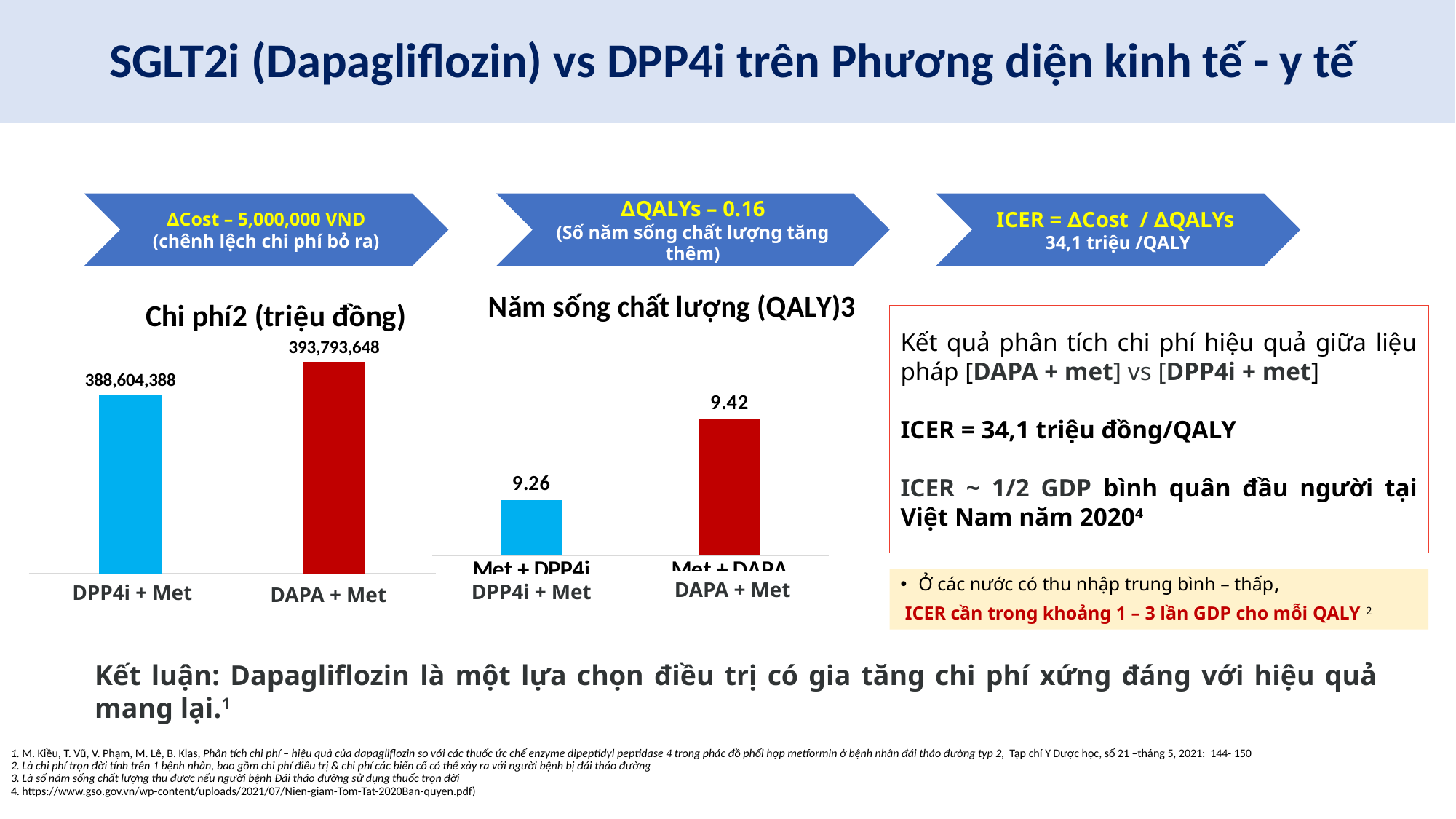
In the 'Chi phí2 (triệu đồng)' chart, which category has the higher value? DAPA + Met In the 'Năm sống chất lượng (QALY)3' chart, which category has the lower value? DPP4i + Met In the 'Năm sống chất lượng (QALY)3' chart, what is the value for DPP4i + Met? 9.26 In the 'Chi phí2 (triệu đồng)' chart, what is the value for DAPA + Met? 393,793,648 How many categories are shown in the 'Chi phí2 (triệu đồng)' chart? 2 In the 'Năm sống chất lượng (QALY)3' chart, what is the difference between the DAPA + Met and DPP4i + Met values? 0.16 In the 'Chi phí2 (triệu đồng)' chart, what is the difference between the DAPA + Met and DPP4i + Met values? 5,189,260 In the 'Chi phí2 (triệu đồng)' chart, what is the value for DPP4i + Met? 388,604,388 In the 'Năm sống chất lượng (QALY)3' chart, is the value for DAPA + Met larger or smaller than the value for DPP4i + Met? larger In the 'Chi phí2 (triệu đồng)' chart, what colour is the DAPA + Met bar? red In the 'Năm sống chất lượng (QALY)3' chart, what is the value for DAPA + Met? 9.42 What type of chart is the 'Năm sống chất lượng (QALY)3' chart? bar chart